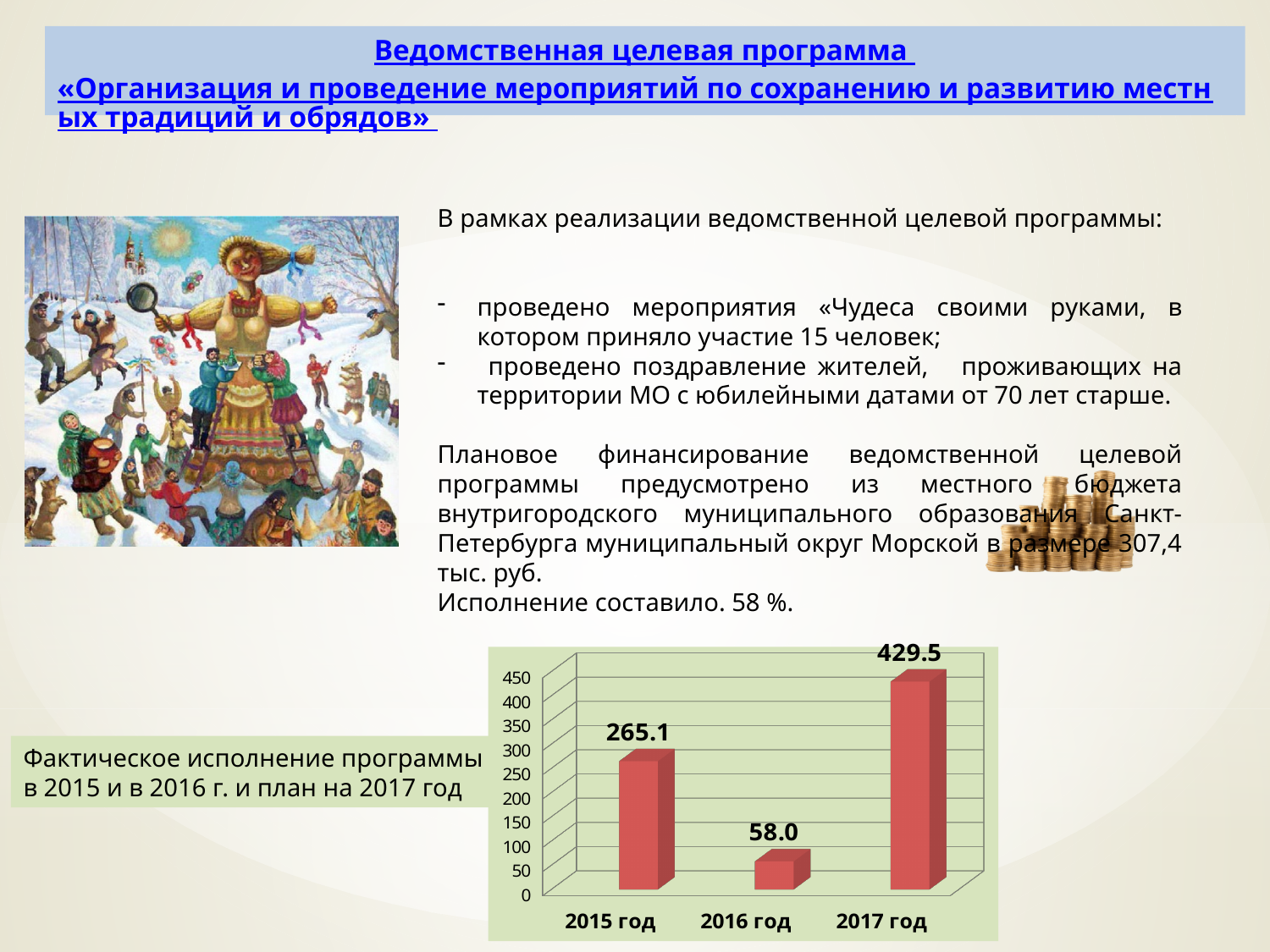
Which is larger, the value for 2015 год or the value for 2016 год? 2015 год What colour are the bars in the chart? red What kind of chart is shown on the slide? bar chart What is the value for 2015 год? 265.1 What is the difference between the values for 2017 год and 2015 год? 164.4 What is the difference between the values for 2015 год and 2016 год? 207.1 What is the value for 2017 год? 429.5 Is the value for 2017 год greater or less than 400? greater What is the value for 2016 год? 58.0 Which year has the highest value? 2017 год How many categories are shown on the x axis of the chart? 3 Which year has the lowest value? 2016 год